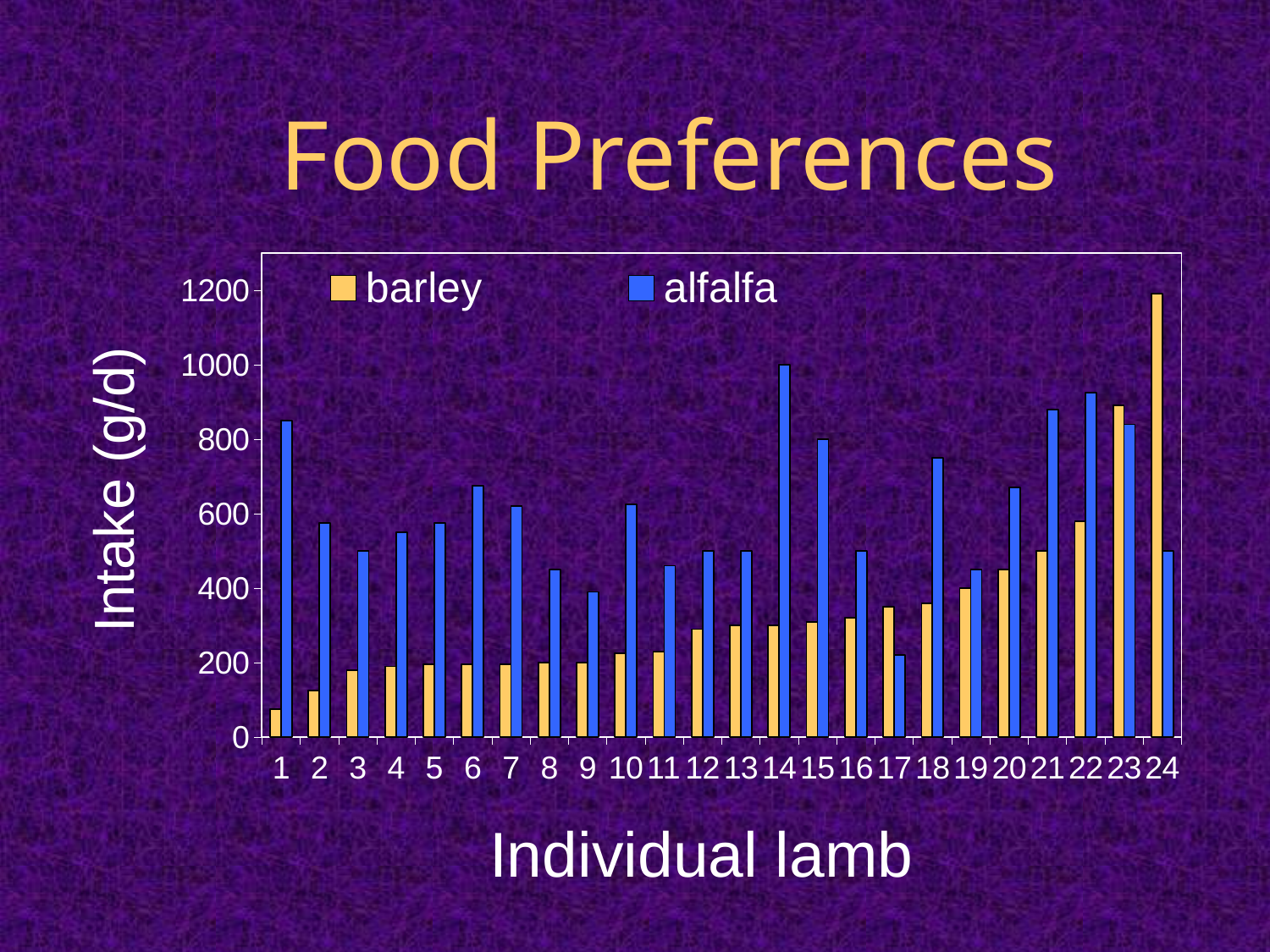
Which lamb has the highest barley intake? 24 Is the alfalfa intake for lamb 17 greater or less than 400? less Is the barley intake for lamb 24 greater or less than 1000? greater How many individual lambs are shown on the x axis? 24 What is the label on the y axis? Intake (g/d) What kind of chart is shown on the slide? bar chart For lamb 1, which is larger: barley intake or alfalfa intake? alfalfa Which lamb has the highest alfalfa intake? 14 Which lamb has the lowest alfalfa intake? 17 Which lamb has the lowest barley intake? 1 How many series does the legend list? 2 Do the barley intake values rise or fall from lamb 1 to lamb 24? rise